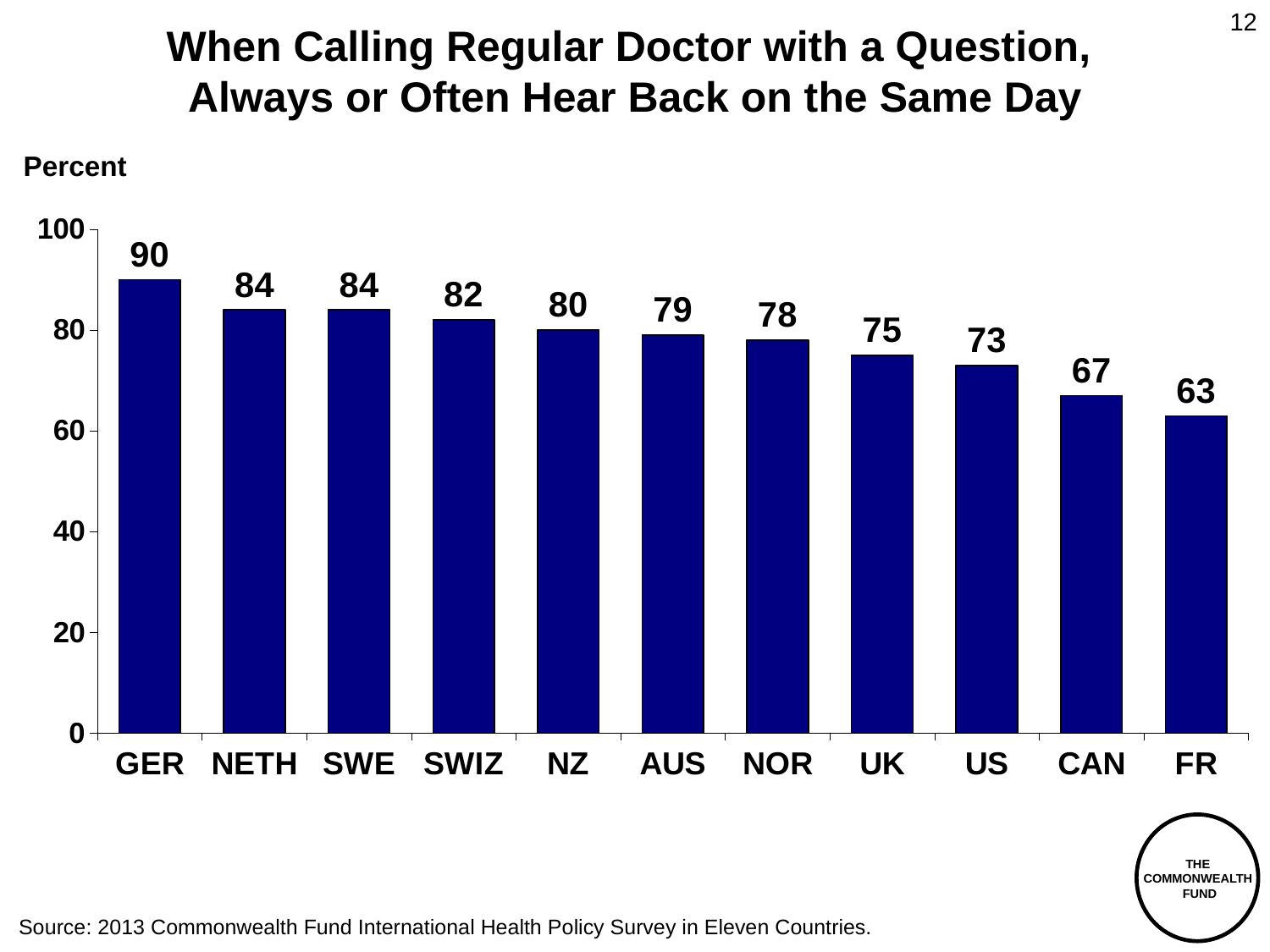
What kind of chart is shown on the slide? bar chart Which is larger, the value for NZ or the value for NOR? NZ Is the value for SWIZ greater or less than 80? greater What is the difference between the values for GER and FR? 27 What is the value for CAN? 67 What is the value for GER? 90 Which country has the highest value? GER How many countries are shown on the chart? 11 Which country has the lowest value? FR Do the values rise or fall from left to right across the countries? fall What is the difference between the values for UK and CAN? 8 What is the value for US? 73